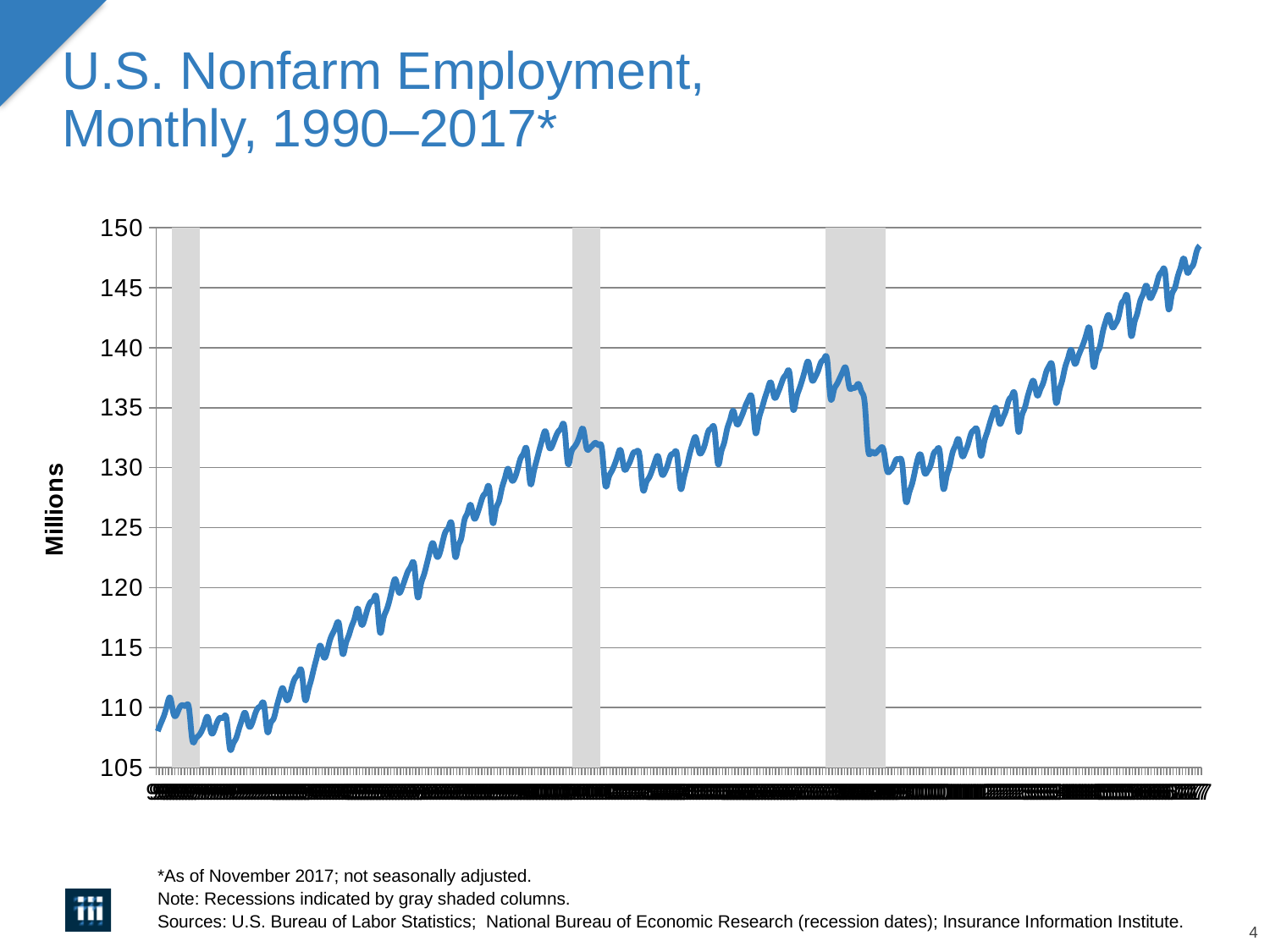
How many gray shaded recession columns are shown on the chart? 3 Overall, do the values rise or fall from the left of the x axis to the right? rise Is the highest point on the line greater or less than 145? greater What kind of chart is shown on the slide? line chart Is the value at the right-hand end of the line greater or less than the value at the left-hand start of the line? greater Is the value at the right-hand end of the line (the most recent month) greater or less than 145? greater Is the lowest point on the line greater or less than 110? less What is the label on the vertical axis of the chart? Millions